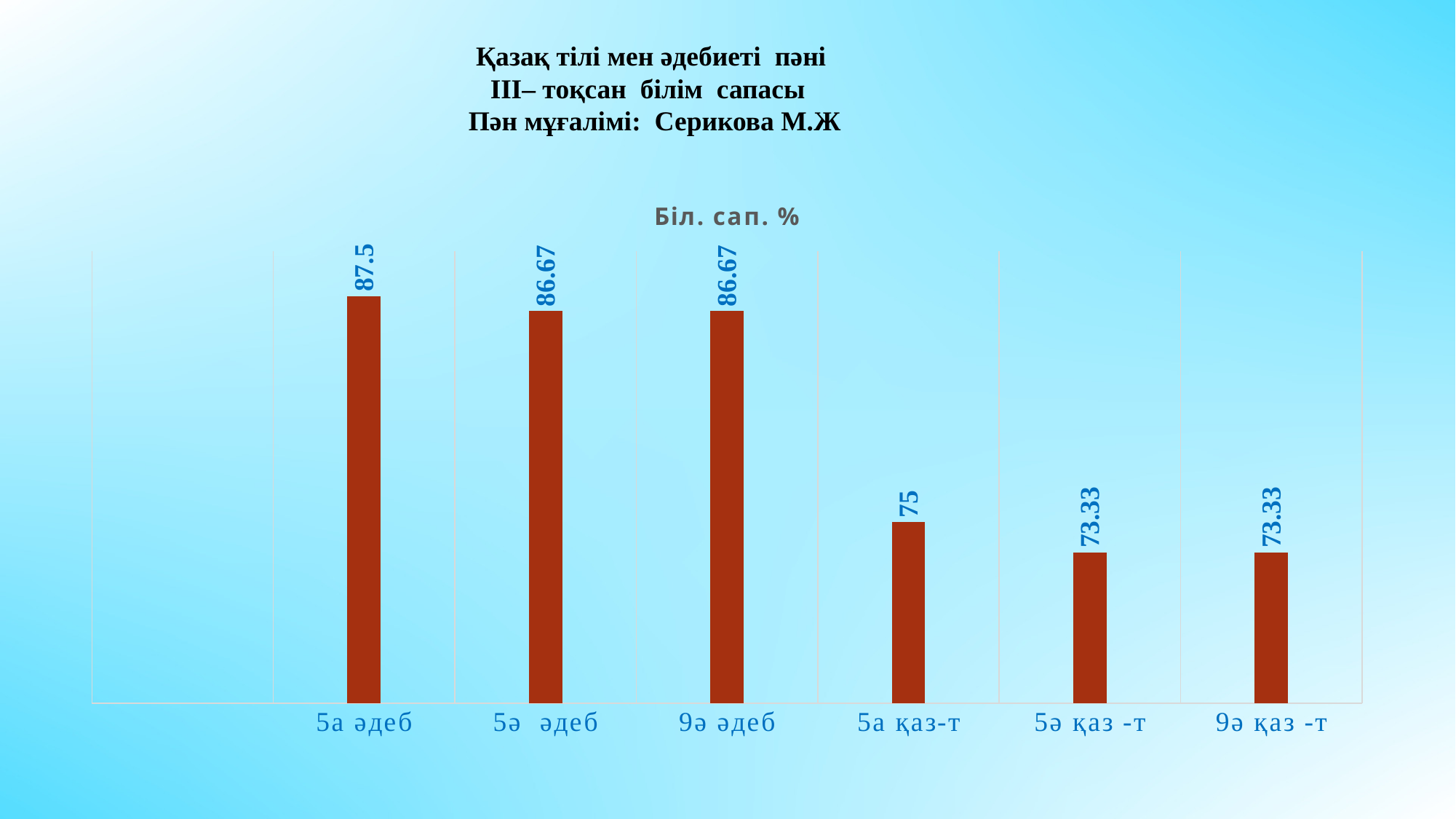
What kind of chart is shown on the slide? Bar chart What is the difference between the values for 5а қаз-т and 5ә қаз -т? 1.67 What is the value for 5ә әдеб? 86.67 How many categories are shown on the x axis? 6 What is the value for 9ә қаз -т? 73.33 What is the lowest value shown in the chart? 73.33 What is the value for 5а қаз-т? 75 What is the value for 5а әдеб? 87.5 Which is larger, the value for 9ә әдеб or the value for 9ә қаз -т? 9ә әдеб Do the values rise or fall from left to right along the x axis? Fall Which category has the highest value? 5а әдеб What is the difference between the values for 5а әдеб and 5а қаз-т? 12.5